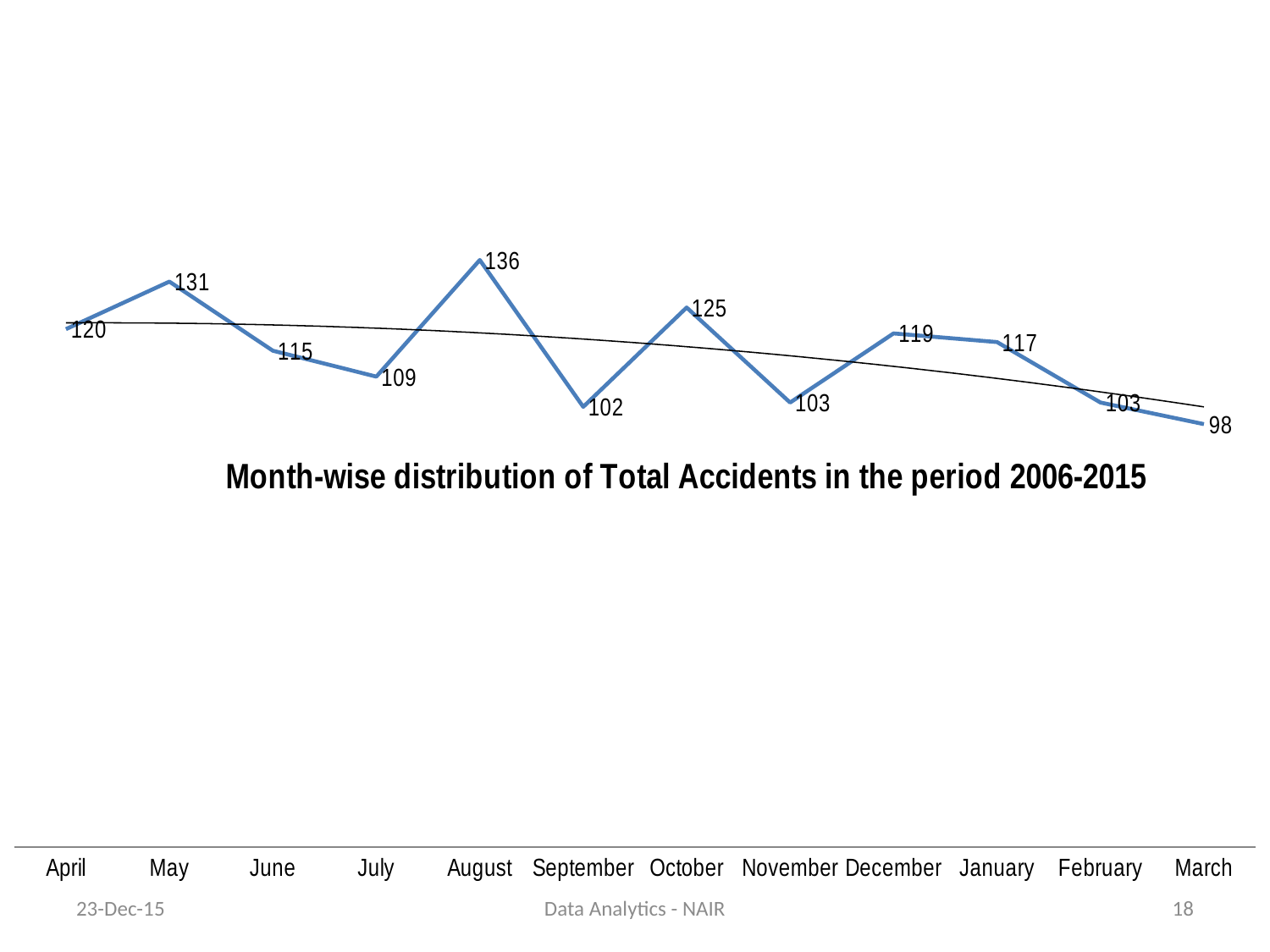
What is the value for March? 98 What is the value for December? 119 What is the title of the chart? Month-wise distribution of Total Accidents in the period 2006-2015 What is the value for August? 136 What is the difference between the values for April and March? 22 Which month has the highest value? August What kind of chart is this? Line chart What is the difference between the values for August and September? 34 Which is larger, the value for May or the value for October? May How many months are plotted on the x axis? 12 Which month has the lowest value? March Which is larger, the value for June or the value for November? June